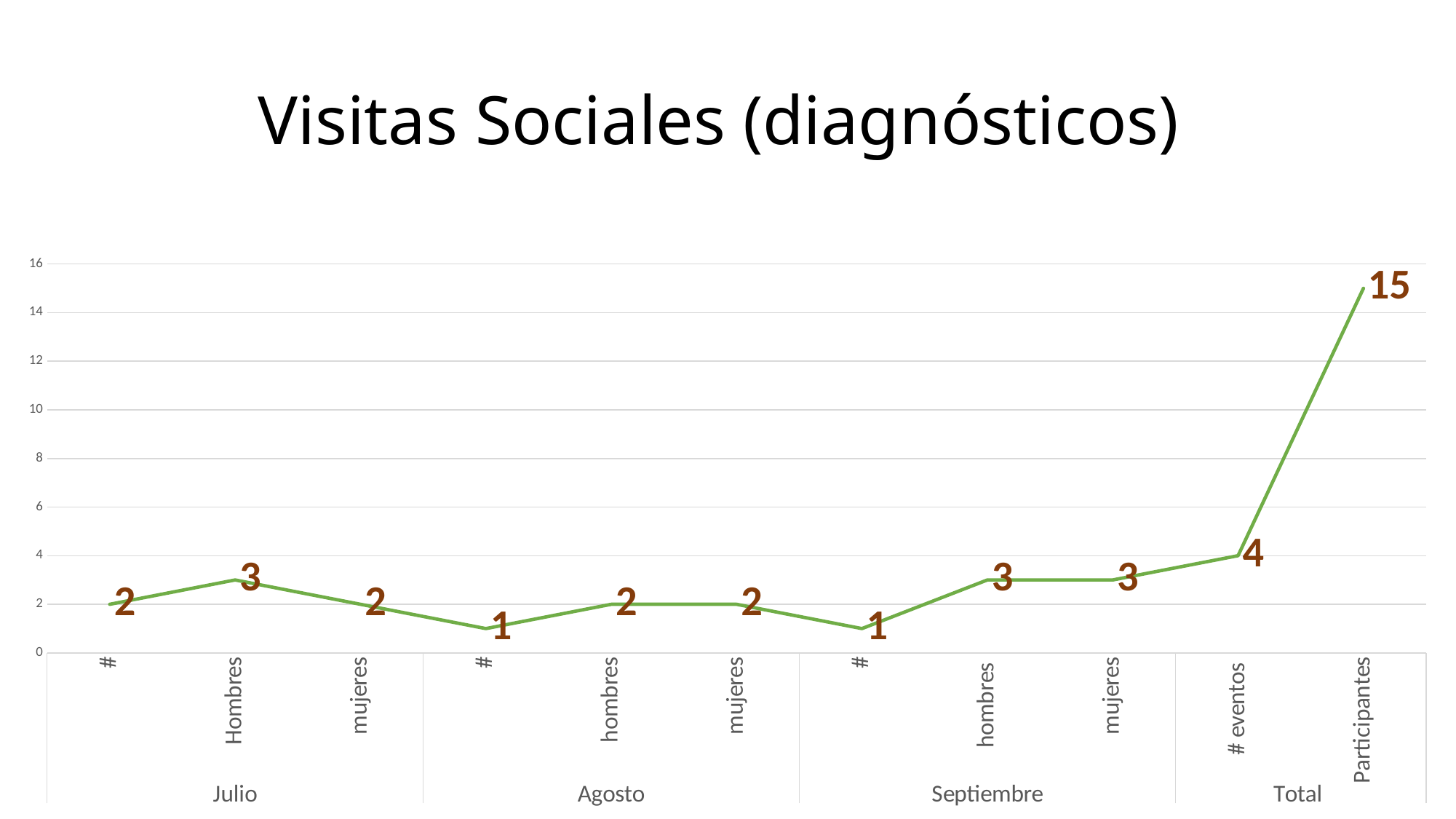
What is the value for Participantes under Total? 15 What is the difference between the value for Participantes and the value for # eventos? 11 Which is larger, the value for hombres in Septiembre or the value for hombres in Agosto? hombres in Septiembre How many month groups (excluding Total) are shown on the x axis? 3 What is the value for Hombres in Julio? 3 How many data points are plotted on the line? 11 Does the line rise or fall between # eventos and Participantes? rise Which category has the highest value? Participantes What is the value for # in Agosto? 1 What type of chart is shown on the slide? line chart What is the title of the chart? Visitas Sociales (diagnósticos) What is the value for # eventos under Total? 4